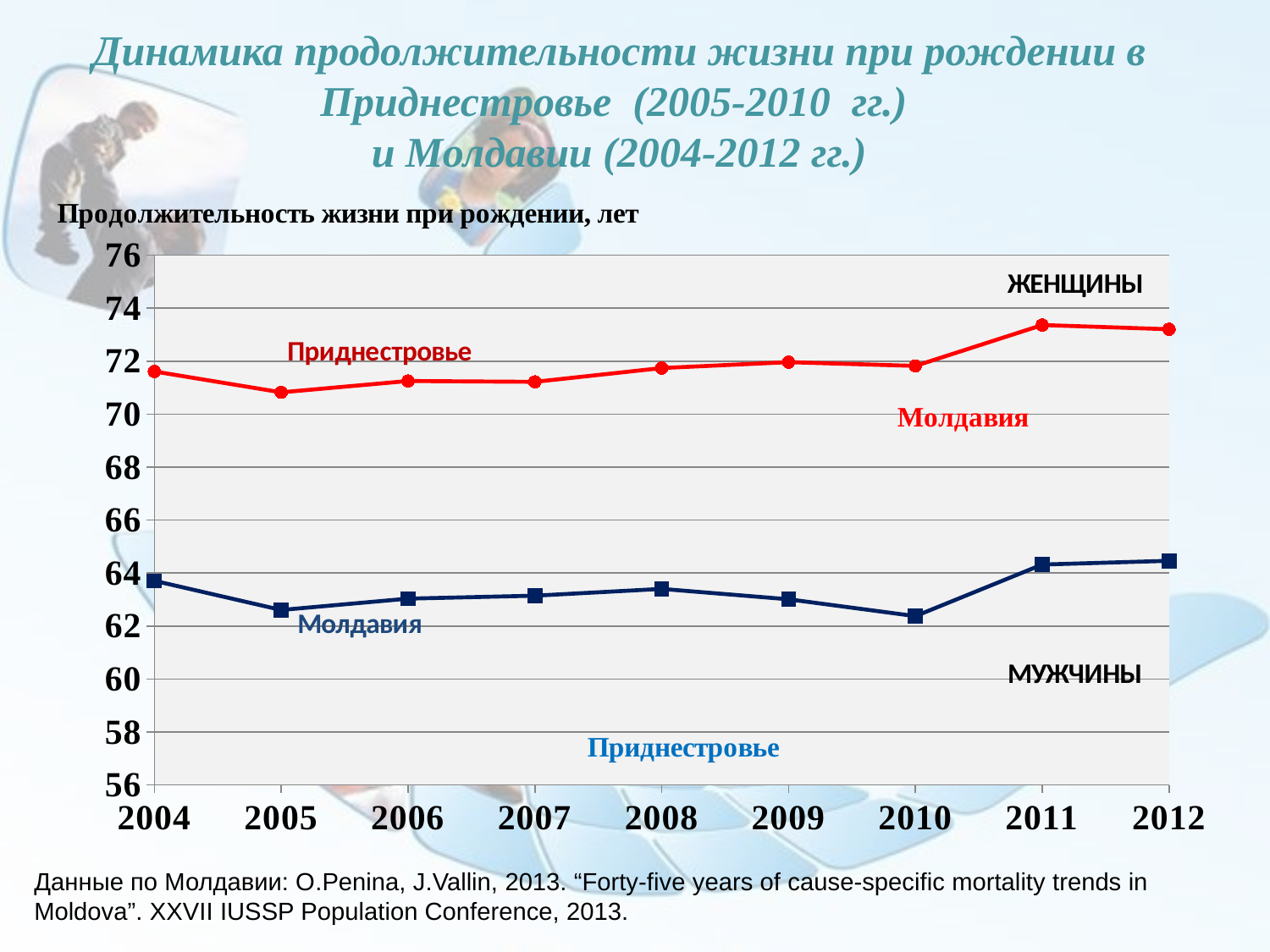
Which year is the first on the x axis of the chart? 2004 Is the value for men (МУЖЧИНЫ) in Moldova in 2012 greater or less than 64? greater Is the value for men (МУЖЧИНЫ) in Moldova in 2005 greater or less than 64? less In which year is the women's (ЖЕНЩИНЫ) life expectancy line for Moldova at its lowest? 2005 For women (ЖЕНЩИНЫ) in Moldova, is the value higher in 2004 or in 2012? 2012 Does the women's (ЖЕНЩИНЫ) line for Moldova rise or fall from 2010 to 2011? rise What is the axis title printed above the chart? Продолжительность жизни при рождении, лет Is the value for men (МУЖЧИНЫ) in Moldova in 2010 greater or less than 64? less What kind of chart is shown on the slide? line chart How many years are shown along the x axis of the chart? 9